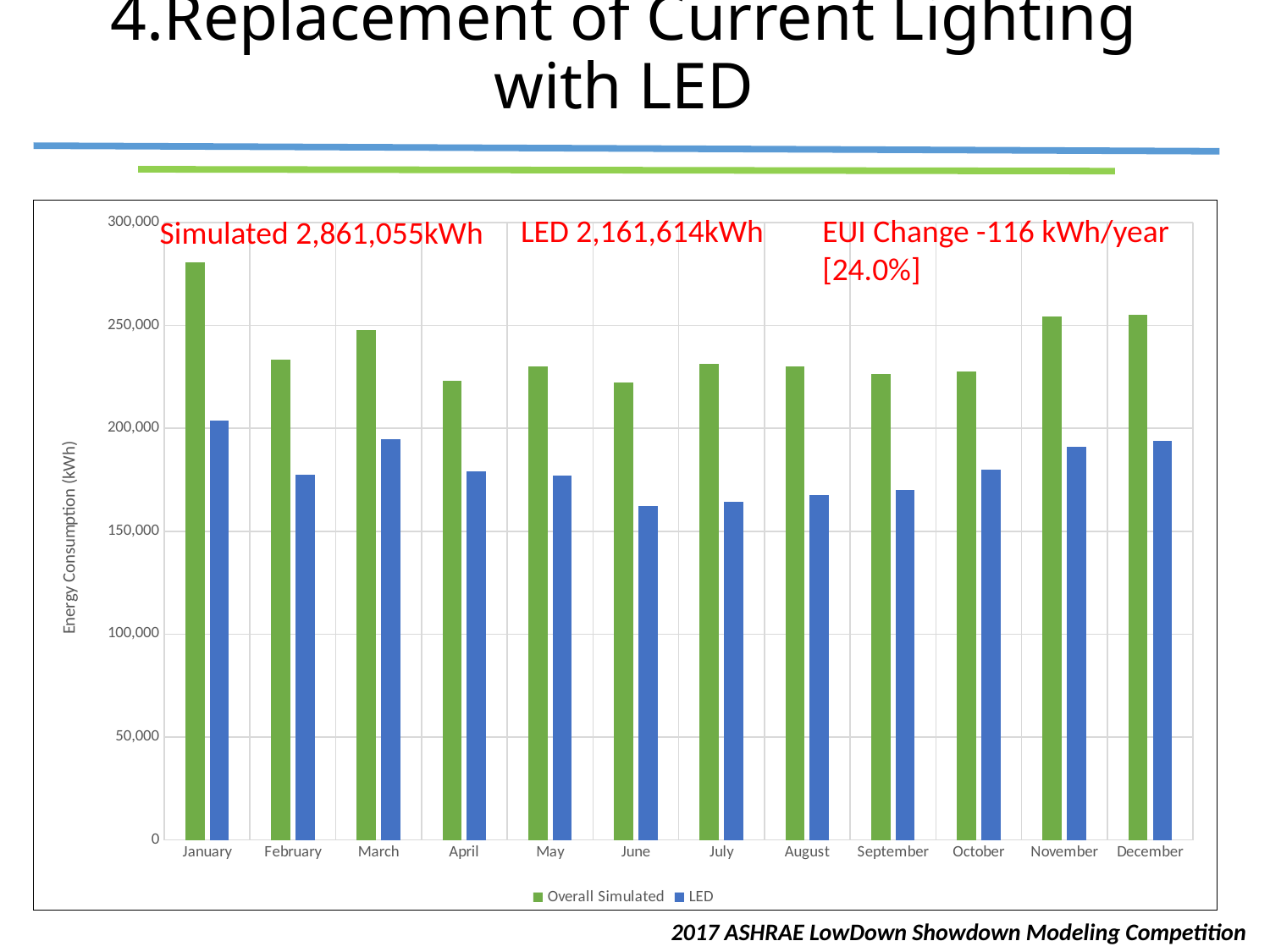
Do the LED values rise or fall from January to June? fall What is the y-axis title of the chart? Energy Consumption (kWh) How many months are shown on the x axis? 12 Which month has the highest Overall Simulated value? January Is the LED value for June greater or less than 200,000? less Which month has the highest LED value? January How many series does the legend list? 2 Which is larger: the LED value for January or the LED value for June? January Which is larger in July: the Overall Simulated value or the LED value? Overall Simulated Is the Overall Simulated value for January greater or less than 250,000? greater Is the Overall Simulated value for April greater or less than 200,000? greater What kind of chart is shown on the slide? bar chart